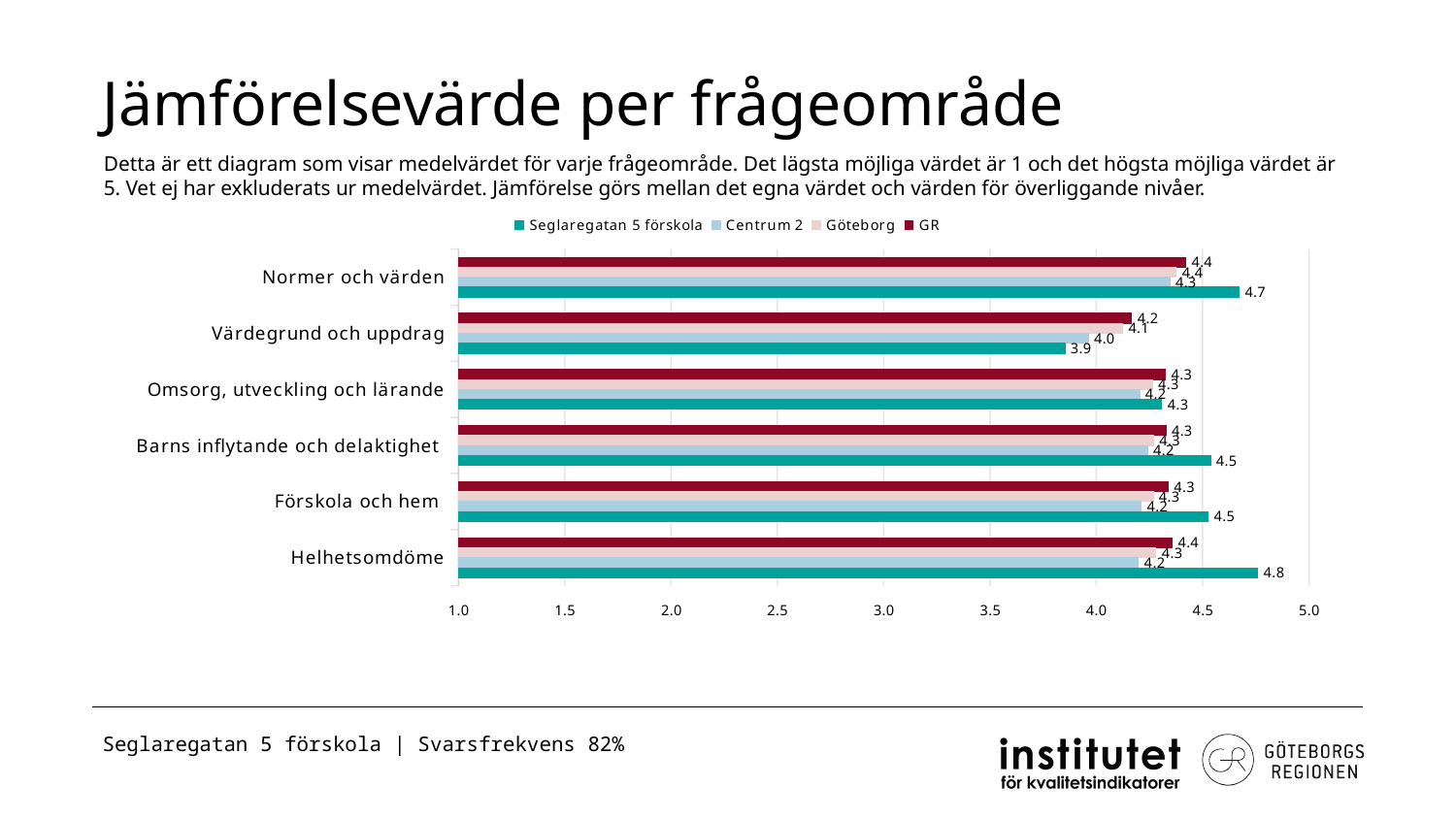
What type of chart is shown on the slide? bar chart How many question areas (categories) are shown on the y axis? 6 Which series is shown in dark red in the legend? GR What is the value for Seglaregatan 5 förskola in Helhetsomdöme? 4.8 Is the value for Seglaregatan 5 förskola in Värdegrund och uppdrag greater or less than 4.0? less Which category has the highest value for Seglaregatan 5 förskola? Helhetsomdöme How many series does the legend list? 4 What is the difference between the Seglaregatan 5 förskola values for Helhetsomdöme and Värdegrund och uppdrag? 0.9 What is the value for Seglaregatan 5 förskola in Barns inflytande och delaktighet? 4.5 Which category has the lowest value for Seglaregatan 5 förskola? Värdegrund och uppdrag What is the value for Seglaregatan 5 förskola in Värdegrund och uppdrag? 3.9 What is the value for Seglaregatan 5 förskola in Normer och värden? 4.7